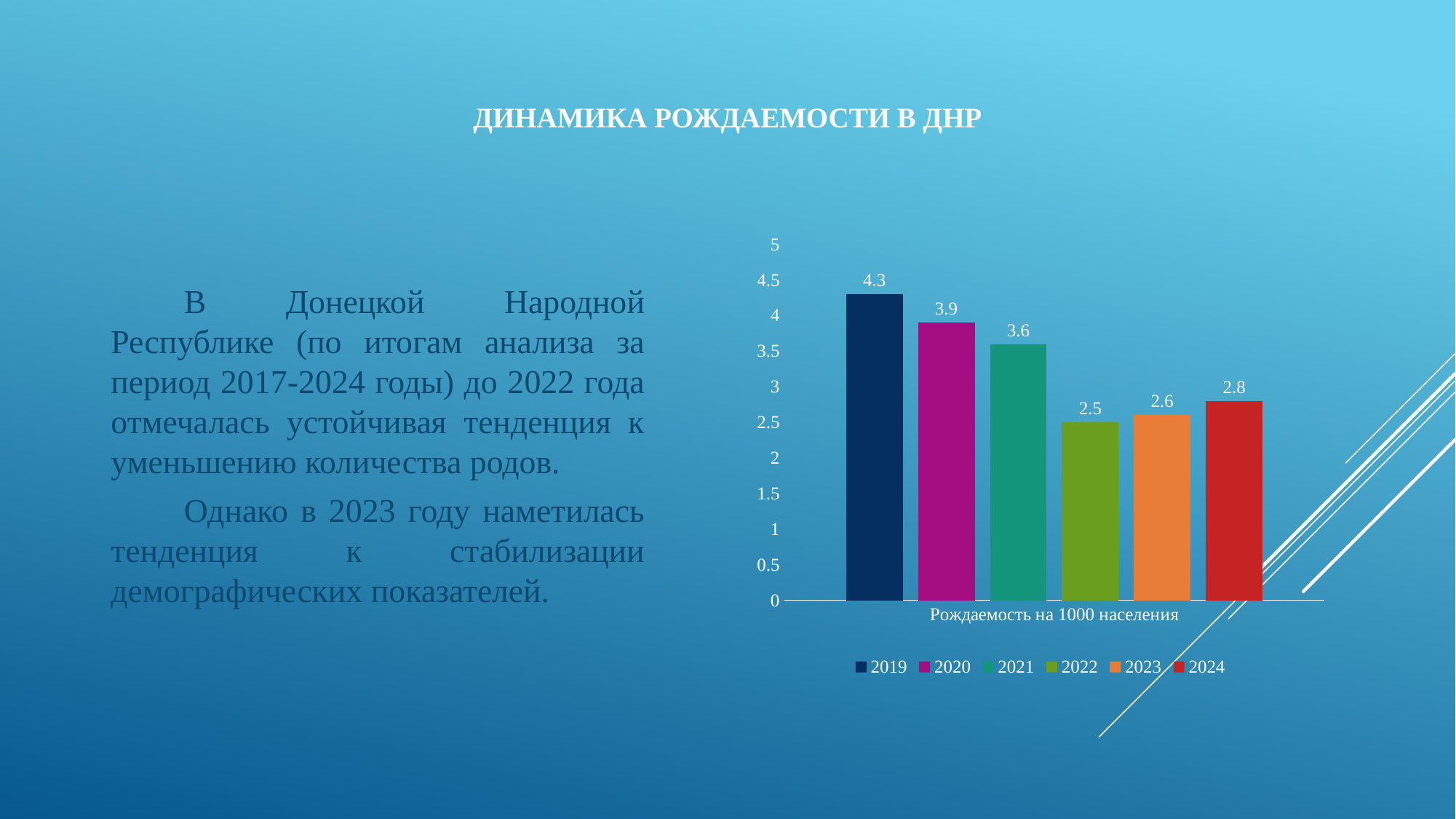
Which year has the lowest birth rate? 2022 Which year has the highest birth rate? 2019 What is the difference between the birth rate in 2019 and in 2022? 1.8 What is the birth rate value for 2019? 4.3 What is the difference between the birth rate in 2020 and in 2021? 0.3 Which is larger, the birth rate in 2023 or in 2024? 2024 What is the birth rate value for 2022? 2.5 What is the label on the x axis under the bars? Рождаемость на 1000 населения Is the value for 2021 greater or less than 3? greater How many series does the legend list? 6 What is the birth rate value for 2024? 2.8 What kind of chart is shown on the slide? bar chart